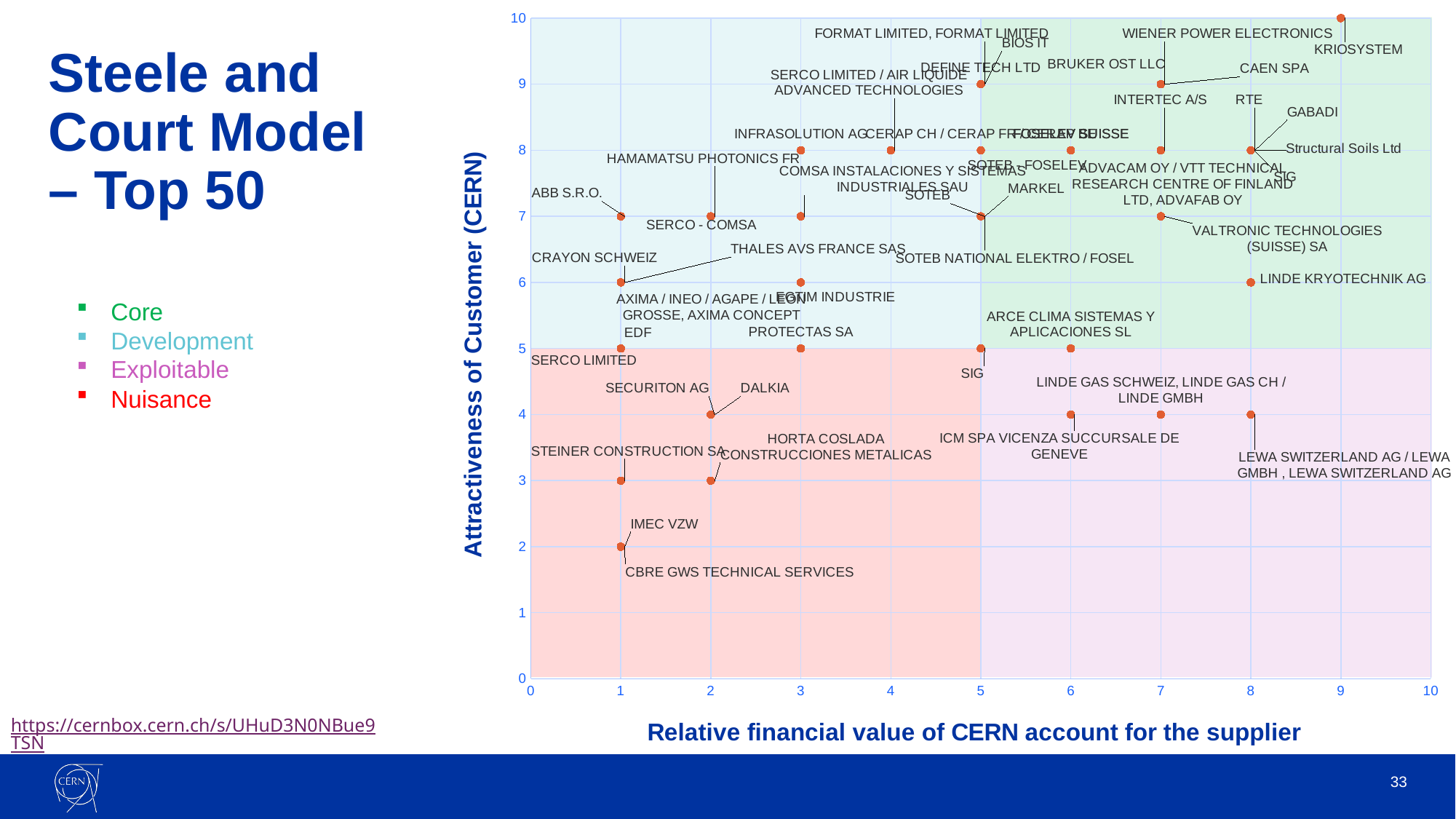
Which has a higher Attractiveness of Customer (CERN) value, LINDE KRYOTECHNIK AG or LEWA SWITZERLAND AG? LINDE KRYOTECHNIK AG What is the Attractiveness of Customer (CERN) value for KRIOSYSTEM? 10 What is the Relative financial value of CERN account for KRIOSYSTEM? 9 What kind of chart is shown on the slide? Scatter plot What is the title of the horizontal axis of the chart? Relative financial value of CERN account for the supplier How many categories does the legend list? 4 Which supplier has the highest Attractiveness of Customer (CERN) value? KRIOSYSTEM What is the title of the vertical axis of the chart? Attractiveness of Customer (CERN) What is the Relative financial value of CERN account for LINDE KRYOTECHNIK AG? 8 What is the Attractiveness of Customer (CERN) value for IMEC VZW? 2 What is the lowest Attractiveness of Customer (CERN) value plotted on the chart? 2 What is the Attractiveness of Customer (CERN) value for LINDE KRYOTECHNIK AG? 6